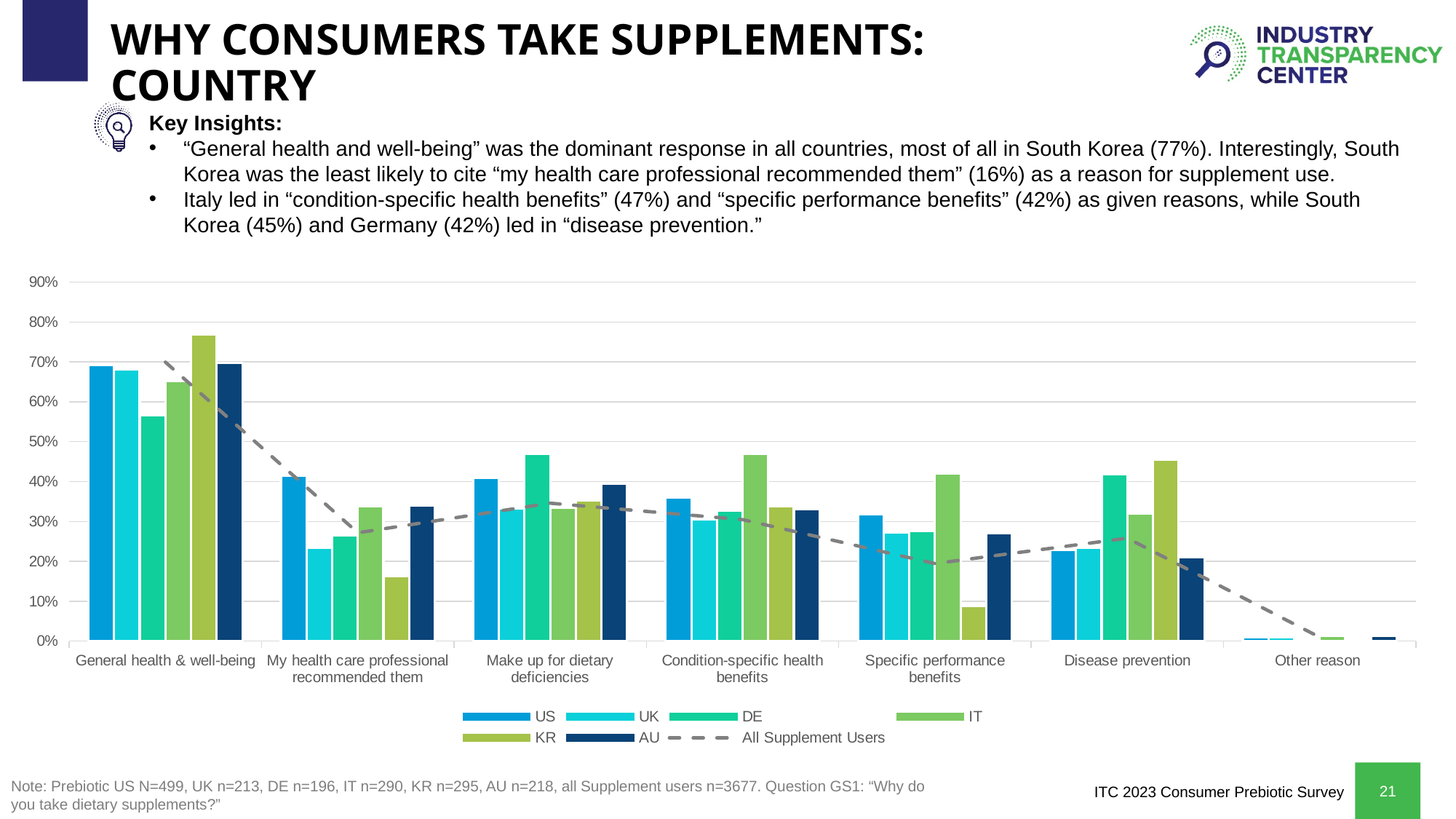
How many reason categories are shown along the x axis? 7 What type of chart is shown on the slide? Bar chart (with a dashed line series) For "Make up for dietary deficiencies", which is larger, the IT bar or the AU bar? AU Which country has the highest bar for "Disease prevention"? KR Is the AU value for "Make up for dietary deficiencies" greater or less than 30%? greater Does the dashed "All Supplement Users" line generally rise or fall from left to right across the categories? Fall Is the KR value for "Specific performance benefits" greater or less than 10%? less Is the US value for "General health & well-being" greater or less than 60%? greater Which country has the lowest bar for "My health care professional recommended them"? KR How many series does the legend list? 7 Which country has the highest bar for "Specific performance benefits"? IT Which country has the highest bar for "General health & well-being"? KR